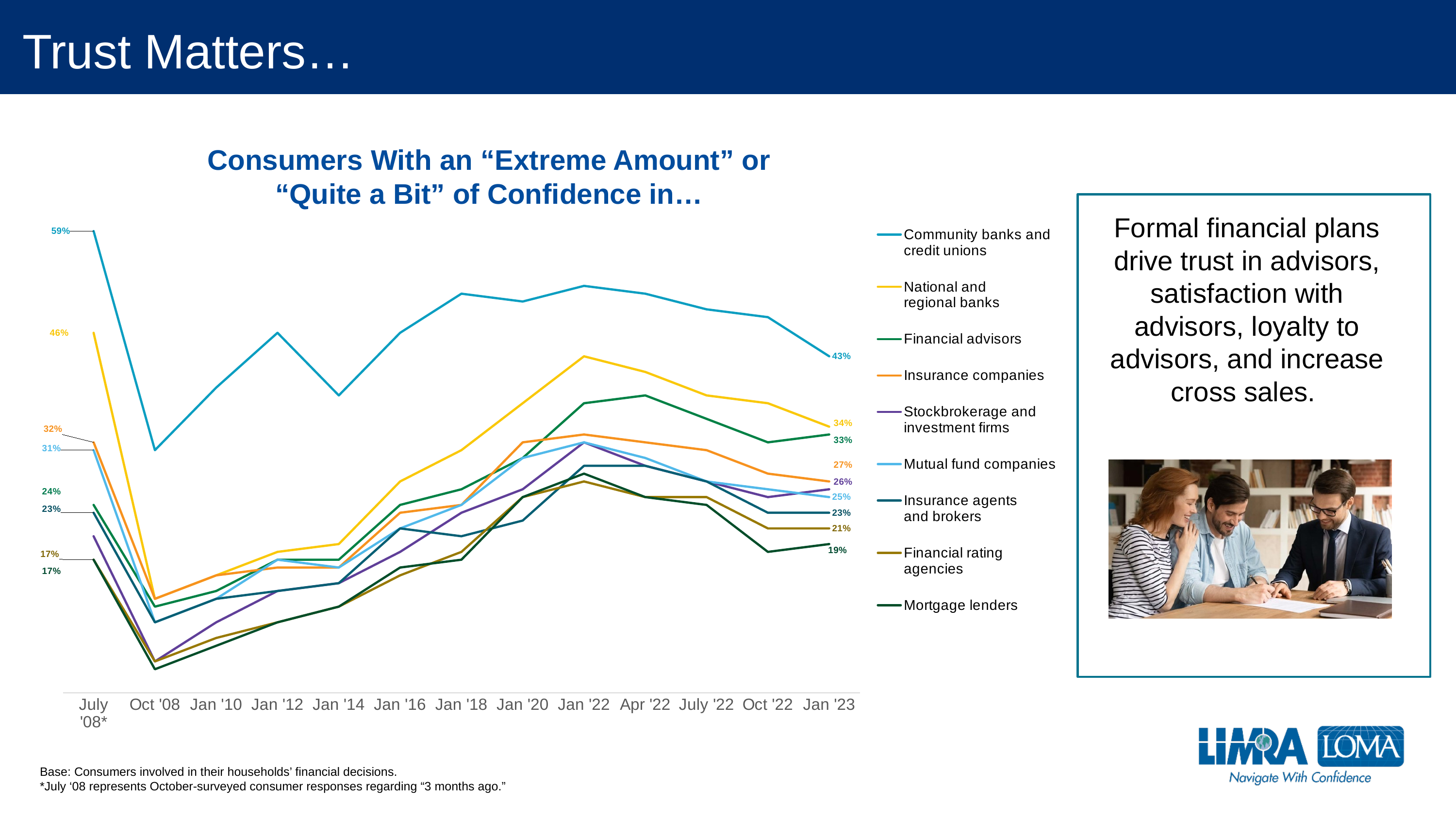
By how many percentage points did the value for Community banks and credit unions change between July '08 and Jan '23? 16 percentage points What is the value for Financial rating agencies at Jan '23? 21% How many time points are shown on the x axis? 13 What is the value for Mortgage lenders at Jan '23? 19% At Jan '23, which is larger: Financial advisors or Insurance companies? Financial advisors Which series has the lowest value at Jan '23? Mortgage lenders What kind of chart is shown on the slide? Line chart What is the value for National and regional banks at July '08? 46% Which series has the highest value at Jan '23? Community banks and credit unions How many series does the legend list? 9 What is the value for Community banks and credit unions at Jan '23? 43% What is the value for Community banks and credit unions at July '08? 59%